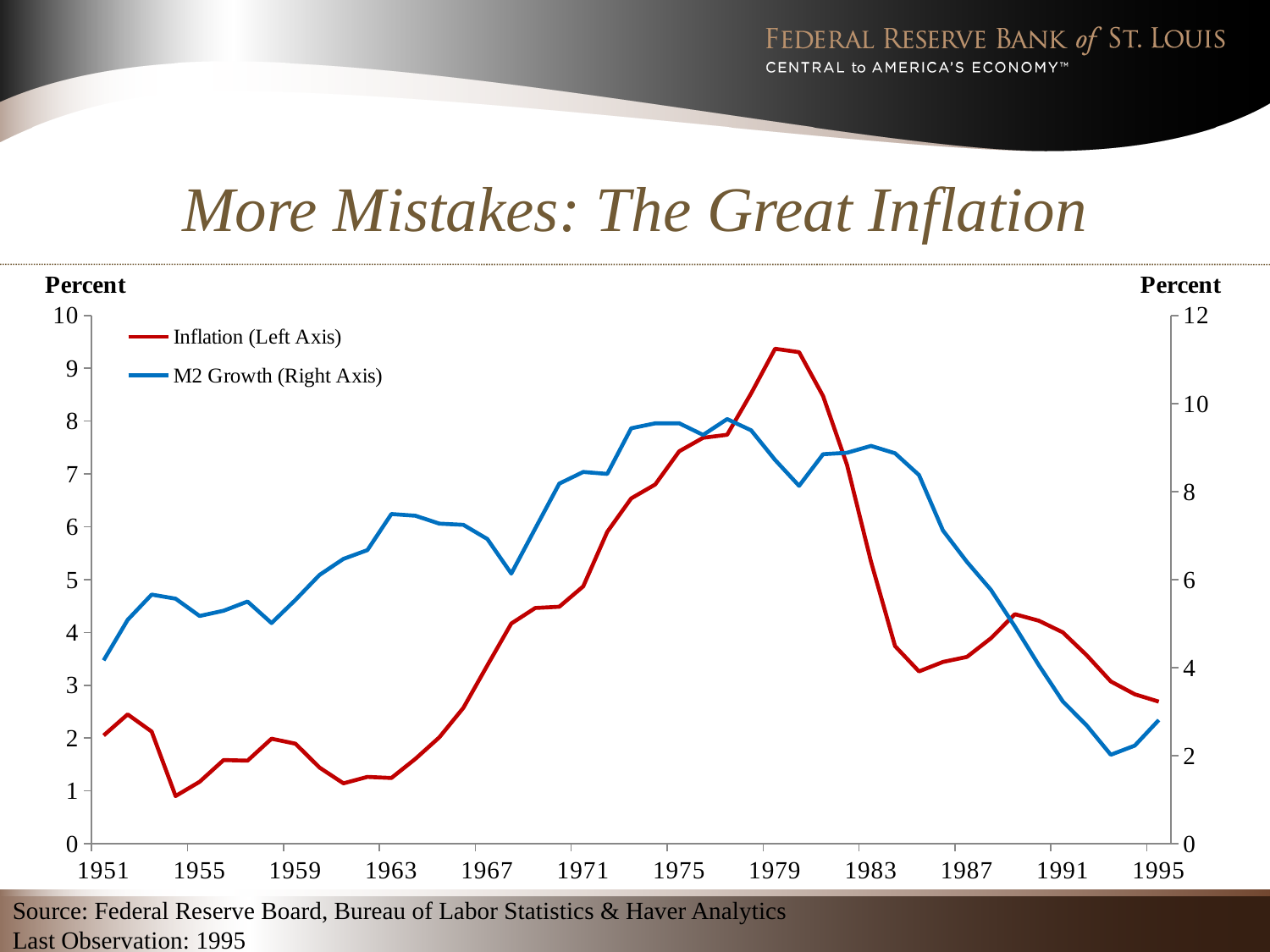
Which axis does the M2 Growth series use according to the legend? Right Axis What is the title of the slide's chart? More Mistakes: The Great Inflation Which year has the higher Inflation value, 1951 or 1979? 1979 Does the M2 Growth line rise or fall between 1983 and 1993? fall Is the Inflation value in 1955 greater or less than 2 on the left axis? less Is the M2 Growth value in 1975 greater or less than 8 on the right axis? greater Does the Inflation line rise or fall between 1963 and 1979? rise How many series does the legend list? 2 Is the M2 Growth value in 1993 greater or less than 4 on the right axis? less How many year labels are shown on the x axis? 12 What kind of chart is shown on the slide? line chart